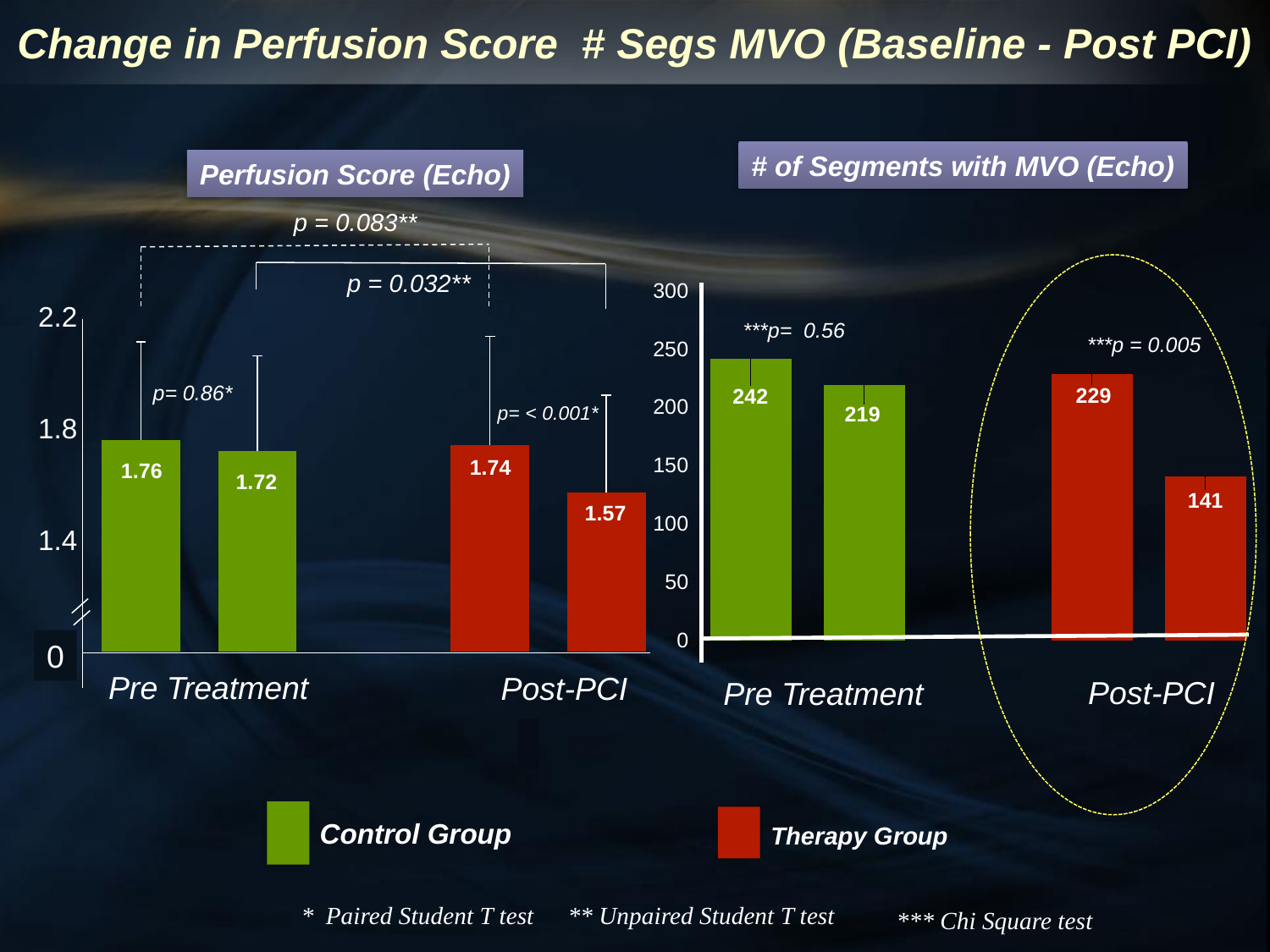
In the # of Segments with MVO (Echo) chart on the right, which bar has the lowest value? the second Post-PCI bar (141) How many categories are shown on the x axis of the Perfusion Score (Echo) chart on the left? 2 What kind of chart is the Perfusion Score (Echo) chart on the left? bar chart In the # of Segments with MVO (Echo) chart on the right, which is larger: the first Post-PCI bar or the second Post-PCI bar? the first Post-PCI bar (229) In the # of Segments with MVO (Echo) chart on the right, what is the difference between the two Post-PCI bars (229 and 141)? 88 In the Perfusion Score (Echo) chart on the left, what is the lowest value shown? 1.57 How many groups does the legend at the bottom of the slide list? 2 In the Perfusion Score (Echo) chart on the left, what is the difference between the two Post-PCI bars (1.74 and 1.57)? 0.17 In the # of Segments with MVO (Echo) chart on the right, what is the value of the second Pre Treatment bar? 219 In the Perfusion Score (Echo) chart on the left, what is the value of the first Pre Treatment bar? 1.76 In the # of Segments with MVO (Echo) chart on the right, what is the highest value shown? 242 In the # of Segments with MVO (Echo) chart on the right, what is the difference between the two Pre Treatment bars (242 and 219)? 23